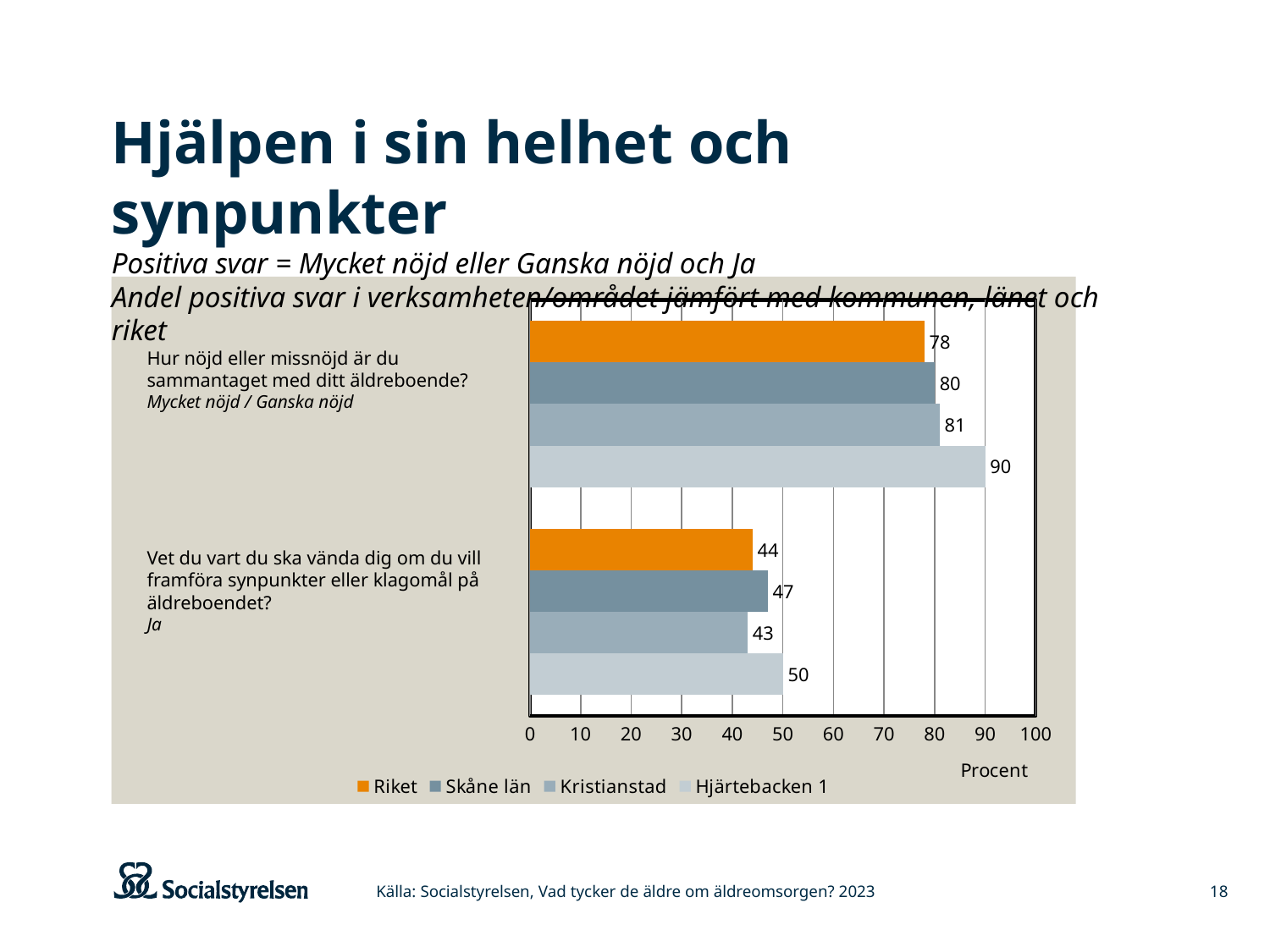
What value is shown for Riket on the question about whether you know where to turn to give feedback or complaints (Vet du vart du ska vända dig...)? 44 How many series does the legend list? 4 What is the label of the x axis of the chart? Procent What is the difference between Hjärtebacken 1 and Riket on the question about overall satisfaction with the elderly home? 12 Which series has the lowest value on the question about whether you know where to turn to give feedback or complaints? Kristianstad What value is shown for Kristianstad on the question about whether you know where to turn to give feedback or complaints? 43 What value is shown for Skåne län on the question about overall satisfaction with the elderly home? 80 What value is shown for Hjärtebacken 1 on the question about how satisfied you are overall with your elderly home (Hur nöjd eller missnöjd är du sammantaget med ditt äldreboende)? 90 What kind of chart is shown on the slide? Bar chart Which series has the highest value on the question about overall satisfaction with the elderly home? Hjärtebacken 1 Which series is shown in orange in the legend? Riket On the question about knowing where to turn with feedback or complaints, which is larger: Skåne län or Riket? Skåne län